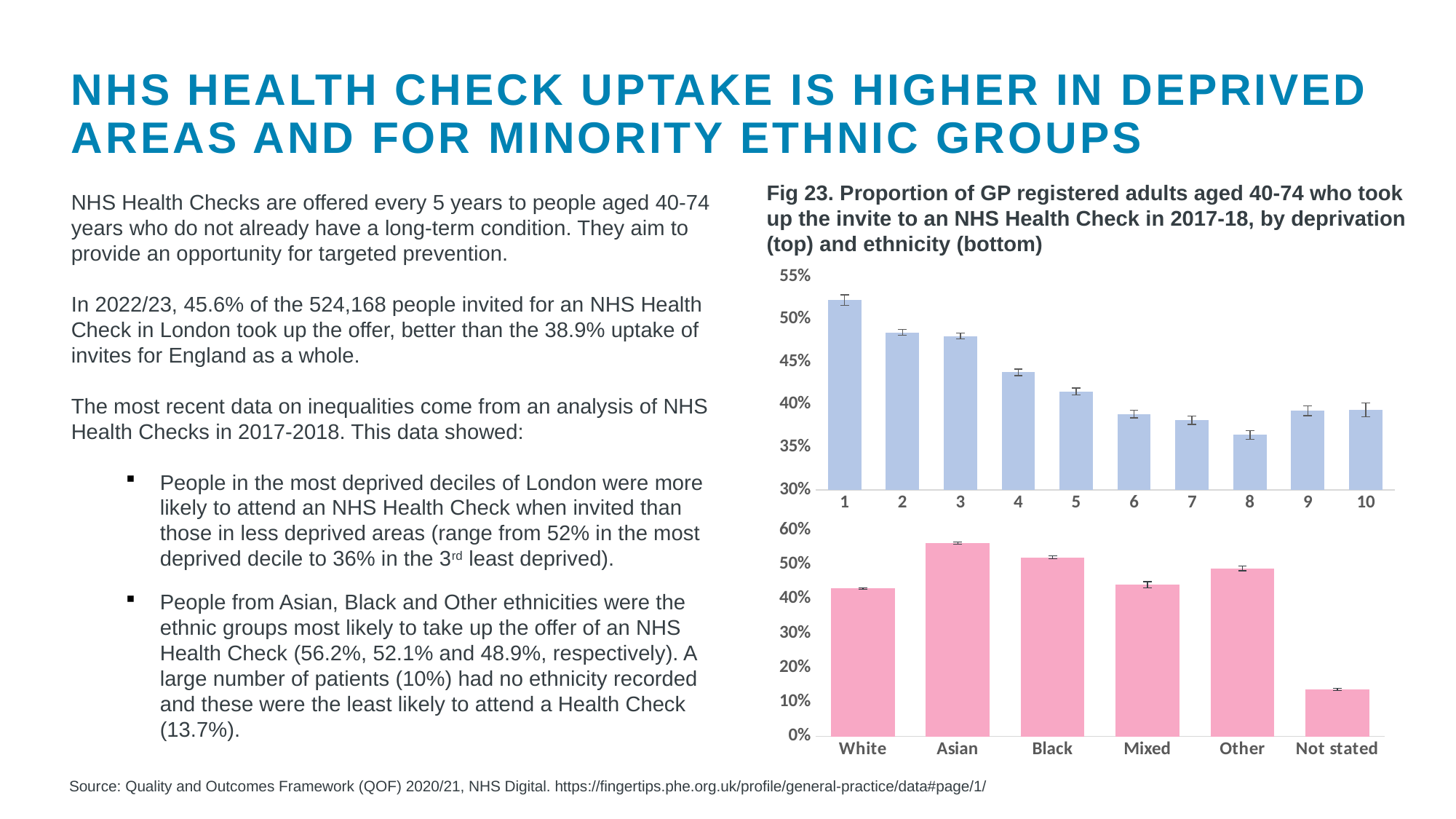
In the top chart (by deprivation decile), is the value for decile 1 greater or less than 50%? greater In the top chart (by deprivation decile), do the values generally rise or fall from decile 1 to decile 8? fall In the top chart (by deprivation decile), how many deciles are plotted? 10 In the bottom chart (by ethnicity), which group has the lowest uptake? Not stated What kind of chart is the bottom chart (by ethnicity)? bar chart In the bottom chart (by ethnicity), how many ethnic groups are plotted? 6 In the top chart (by deprivation decile), is the value for decile 8 greater or less than 40%? less In the top chart (by deprivation decile), which is larger, the value for decile 2 or decile 5? decile 2 In the bottom chart (by ethnicity), is the value for Not stated greater or less than 20%? less In the top chart (by deprivation decile), which decile has the lowest uptake? 8 In the bottom chart (by ethnicity), which group has the highest uptake? Asian In the top chart (by deprivation decile), which decile has the highest uptake? 1